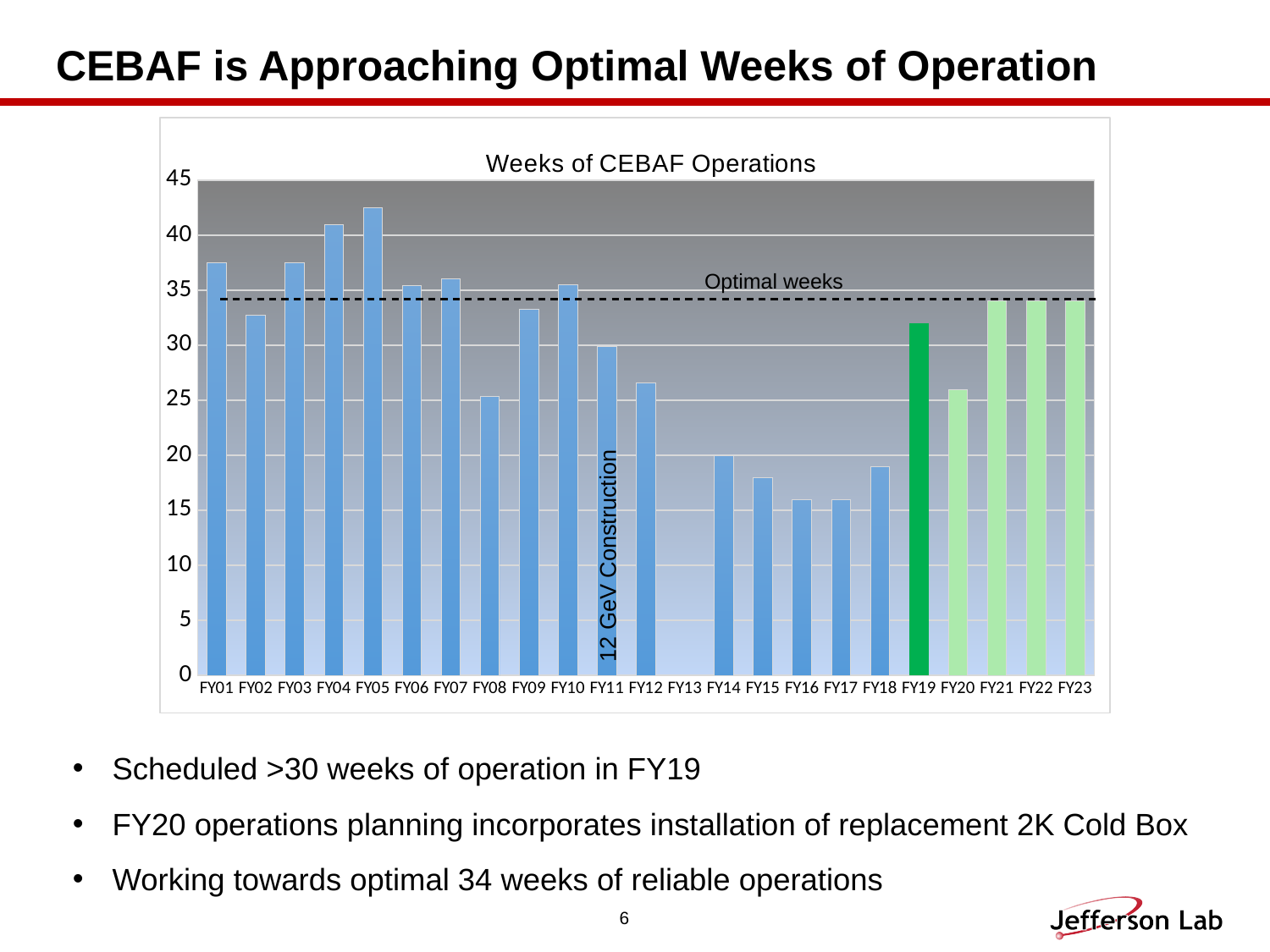
Is the value for FY12 greater or less than 30? less What label is written in the gap at FY13 where no bar is plotted? 12 GeV Construction Which is larger, the value for FY19 or the value for FY20? FY19 What kind of chart is shown on the slide? bar chart Do the values rise or fall from FY14 to FY16? fall Which is larger, the value for FY04 or the value for FY08? FY04 What is the title of the chart? Weeks of CEBAF Operations Which fiscal year has the highest number of weeks of CEBAF operations? FY05 Is the value for FY05 greater or less than 40? greater Is the value for FY16 greater or less than 20? less How many fiscal year categories are labelled on the x axis? 23